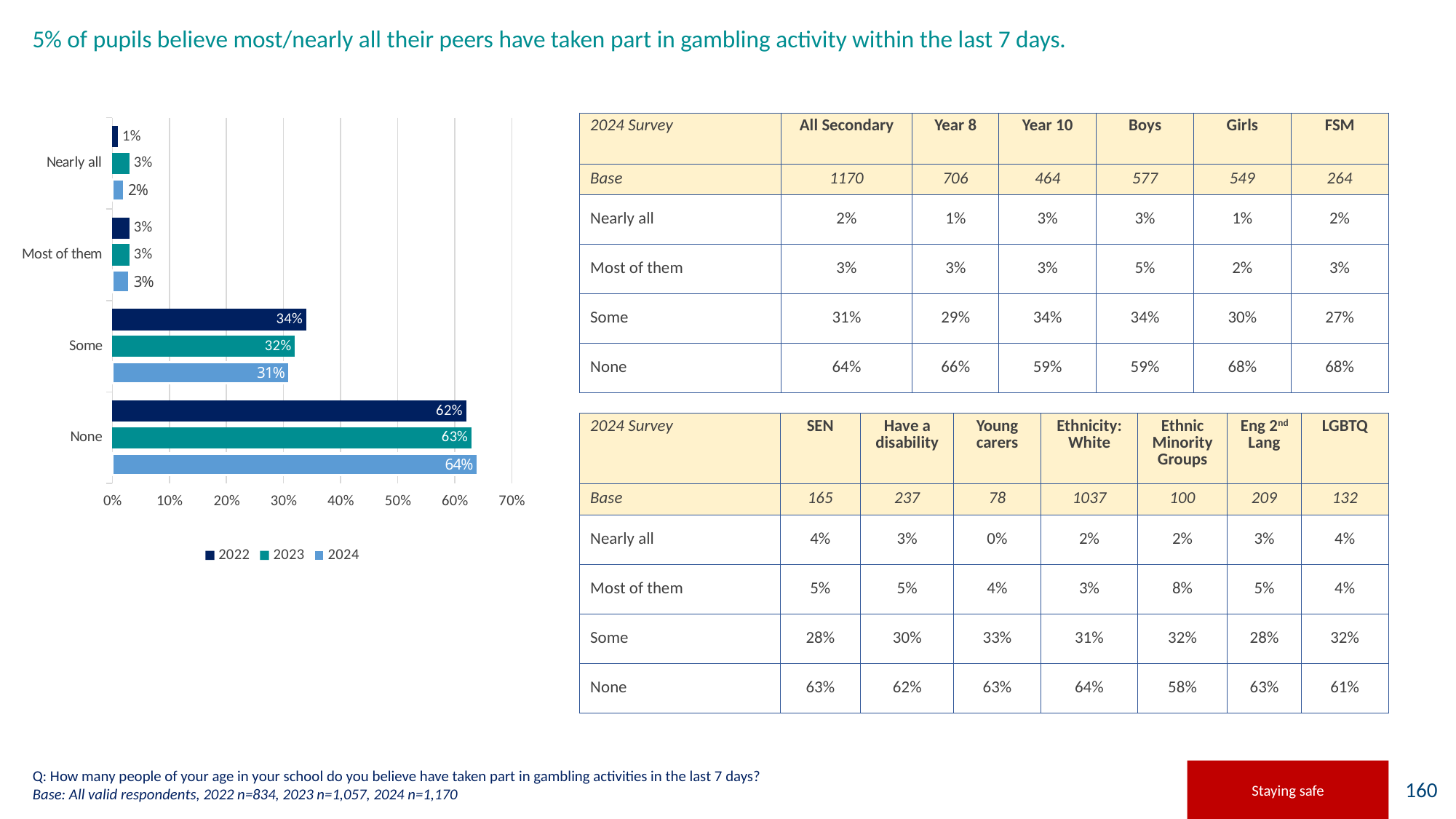
Which series is shown in the darkest blue colour? 2022 What is the difference between the 2022 and 2024 values for None? 2% What is the value for Nearly all in 2023? 3% How many categories are shown on the chart? 4 What kind of chart is shown on the slide? Bar chart Which category has the highest value in 2024? None What is the value for Most of them in 2024? 3% What is the value for None in 2024? 64% How many series does the legend list? 3 Which is larger, the 2022 value for Some or the 2024 value for Some? 2022 Which category has the lowest value in 2022? Nearly all What is the value for Some in 2022? 34%